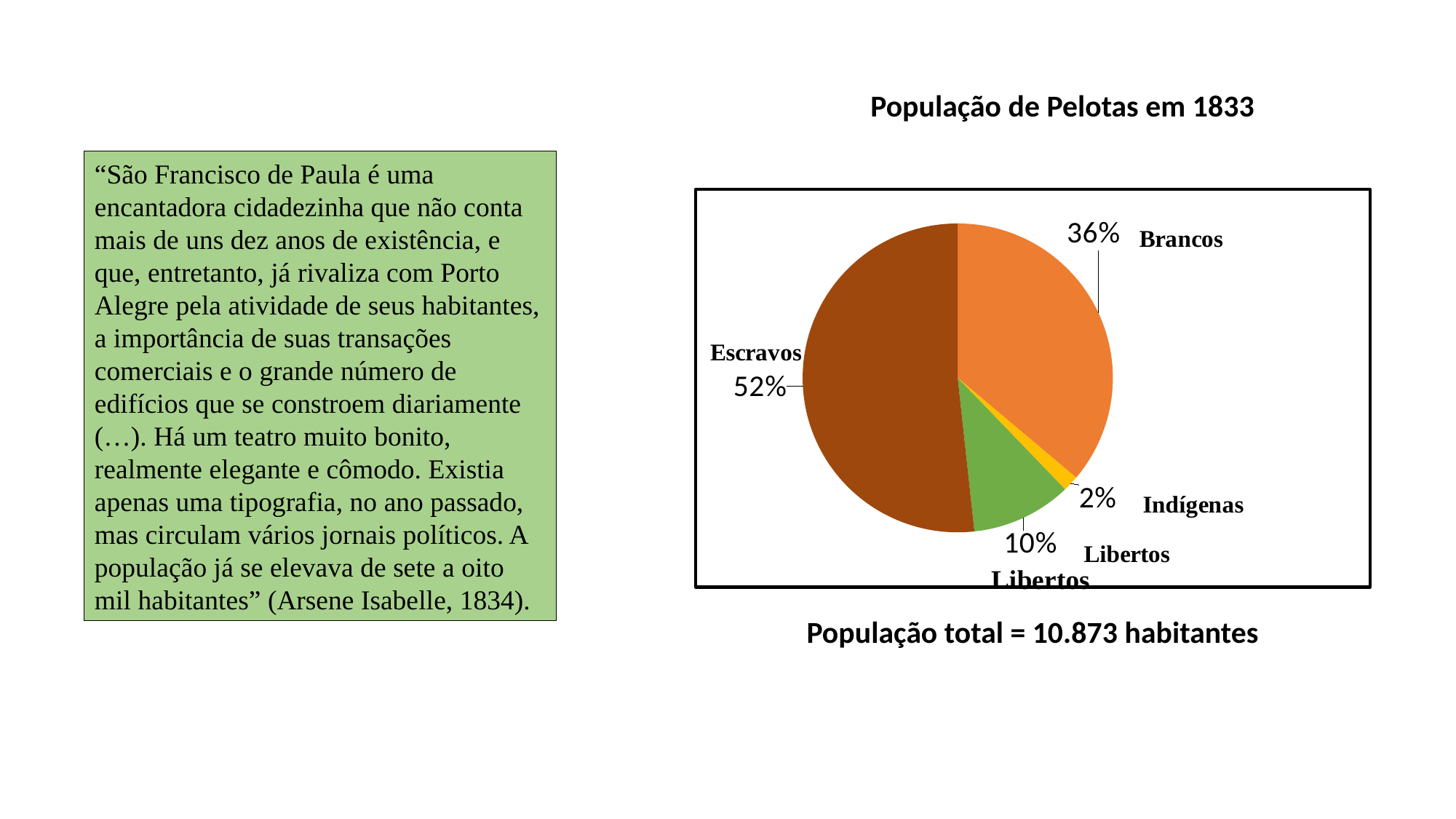
What is the title of the chart? População de Pelotas em 1833 What share of the pie does Escravos represent? 52% What share of the pie does Brancos represent? 36% What kind of chart is shown on the slide? Pie chart What is the difference in percentage points between Escravos and Brancos? 16 Which category has the smallest slice of the pie? Indígenas How many categories are shown in the pie chart? 4 Which category has the largest slice of the pie? Escravos What share of the pie does Libertos represent? 10% What is the difference in percentage points between Libertos and Indígenas? 8 Which is larger, the share for Brancos or the share for Libertos? Brancos What share of the pie does Indígenas represent? 2%